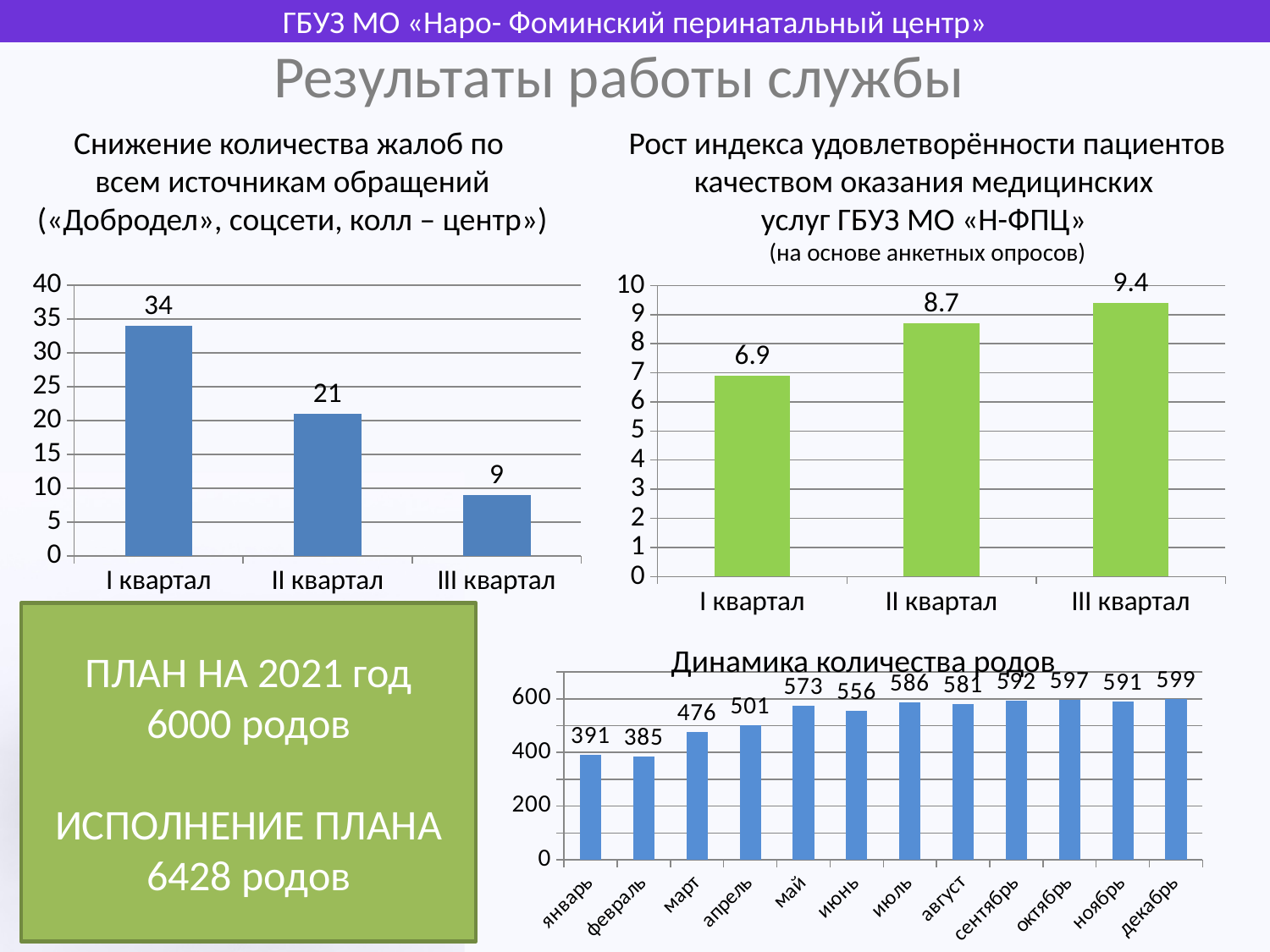
What kind of chart is 'Динамика количества родов'? bar chart In the chart 'Динамика количества родов', which month has the lowest value? февраль In the chart 'Динамика количества родов', what is the value for март? 476 In the top-left chart on reducing the number of complaints, which quarter has the lowest value? III квартал In the chart 'Динамика количества родов', how many months are plotted? 12 In the top-right chart on the patient satisfaction index, what is the difference between III квартал and II квартал? 0.7 In the chart 'Динамика количества родов', which month has the highest value? декабрь In the top-right chart on the patient satisfaction index, what is the value for I квартал? 6.9 In the top-left chart on reducing the number of complaints, what is the difference between I квартал and III квартал? 25 In the top-left chart on reducing the number of complaints, do the values rise or fall from I квартал to III квартал? fall In the top-left chart on reducing the number of complaints, what is the value for II квартал? 21 In the top-right chart on the patient satisfaction index, which quarter has the highest value? III квартал